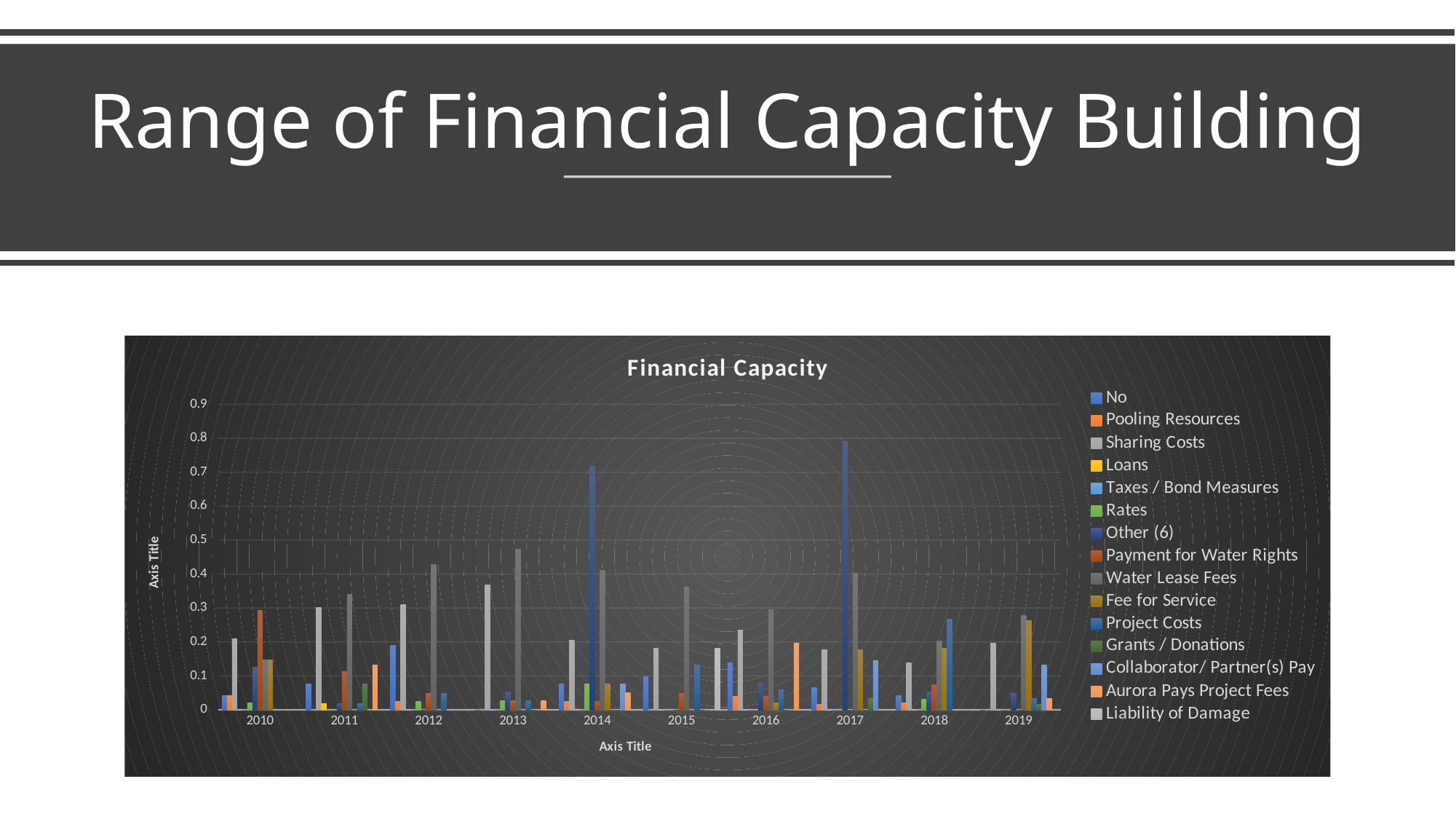
What is the first year shown on the x axis? 2010 Is the tallest bar in 2010 greater or less than 0.4? less What is the last year shown on the x axis? 2019 How many series does the chart's legend list? 15 How many years are shown along the x axis of the chart? 10 What kind of chart is shown on the slide? bar chart In which year does the tallest bar in the chart appear? 2017 What is the title of the chart? Financial Capacity Is the tallest bar in 2017 greater or less than 0.7? greater What is the highest value shown on the y axis? 0.9 Which is taller: the tallest bar in 2017 or the tallest bar in 2014? 2017 Is the tallest bar in 2014 greater or less than 0.6? greater